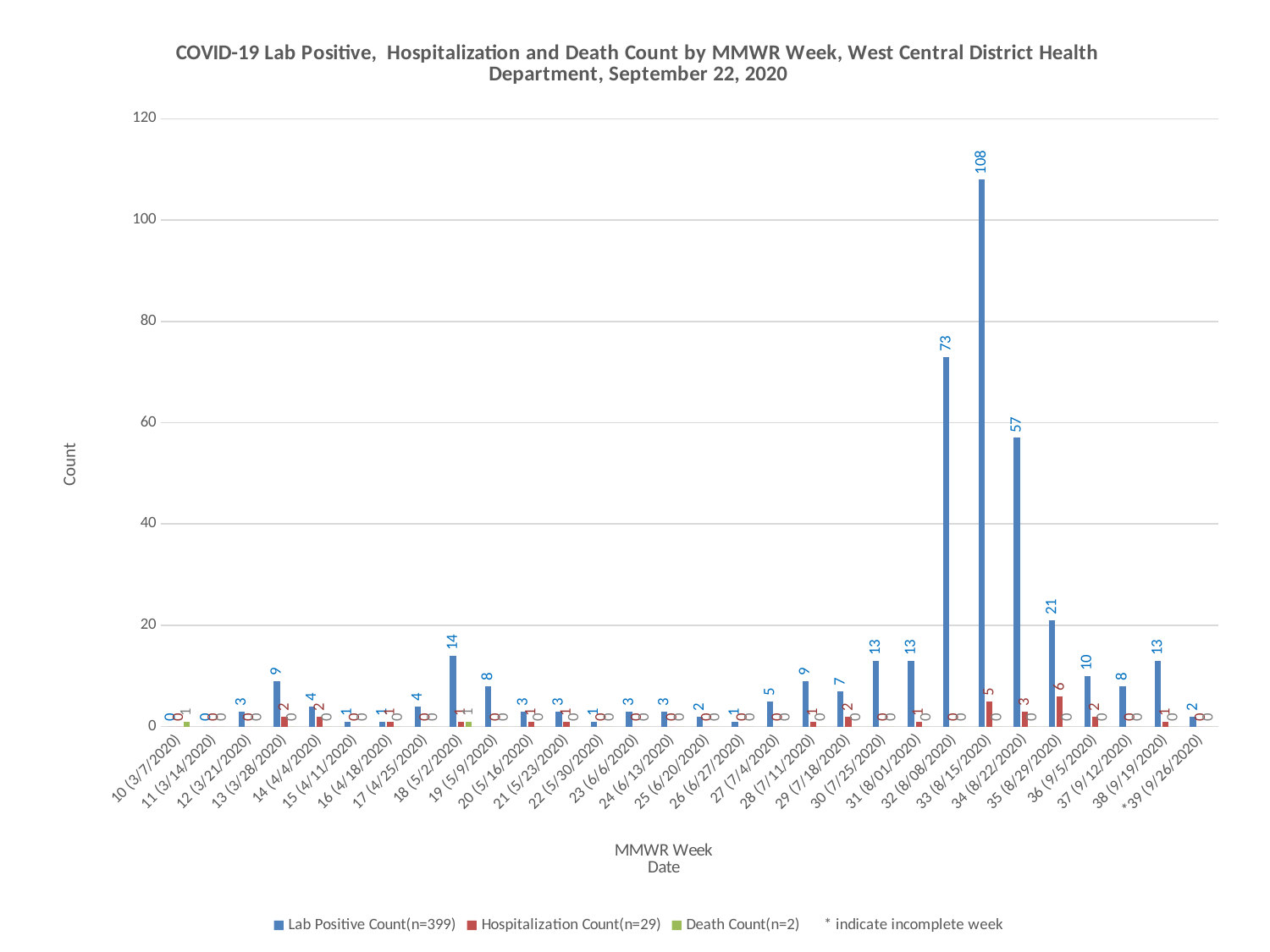
According to the legend, what is the total n for the Hospitalization Count series? 29 Which MMWR week has the highest Lab Positive Count? 33 (8/15/2020) Which MMWR week has the highest Hospitalization Count? 35 (8/29/2020) Is the Lab Positive Count for week 32 (8/08/2020) greater or less than 60? greater What is the difference between the Lab Positive Count for week 33 (8/15/2020) and week 32 (8/08/2020)? 35 What is the Lab Positive Count for MMWR week 33 (8/15/2020)? 108 What kind of chart is shown on the slide? Bar chart How many MMWR weeks are shown on the x axis? 30 What is the Lab Positive Count for MMWR week 18 (5/2/2020)? 14 Which is larger, the Lab Positive Count for week 34 (8/22/2020) or for week 35 (8/29/2020)? 34 (8/22/2020) What is the Hospitalization Count for MMWR week 35 (8/29/2020)? 6 How many series does the legend list? 3